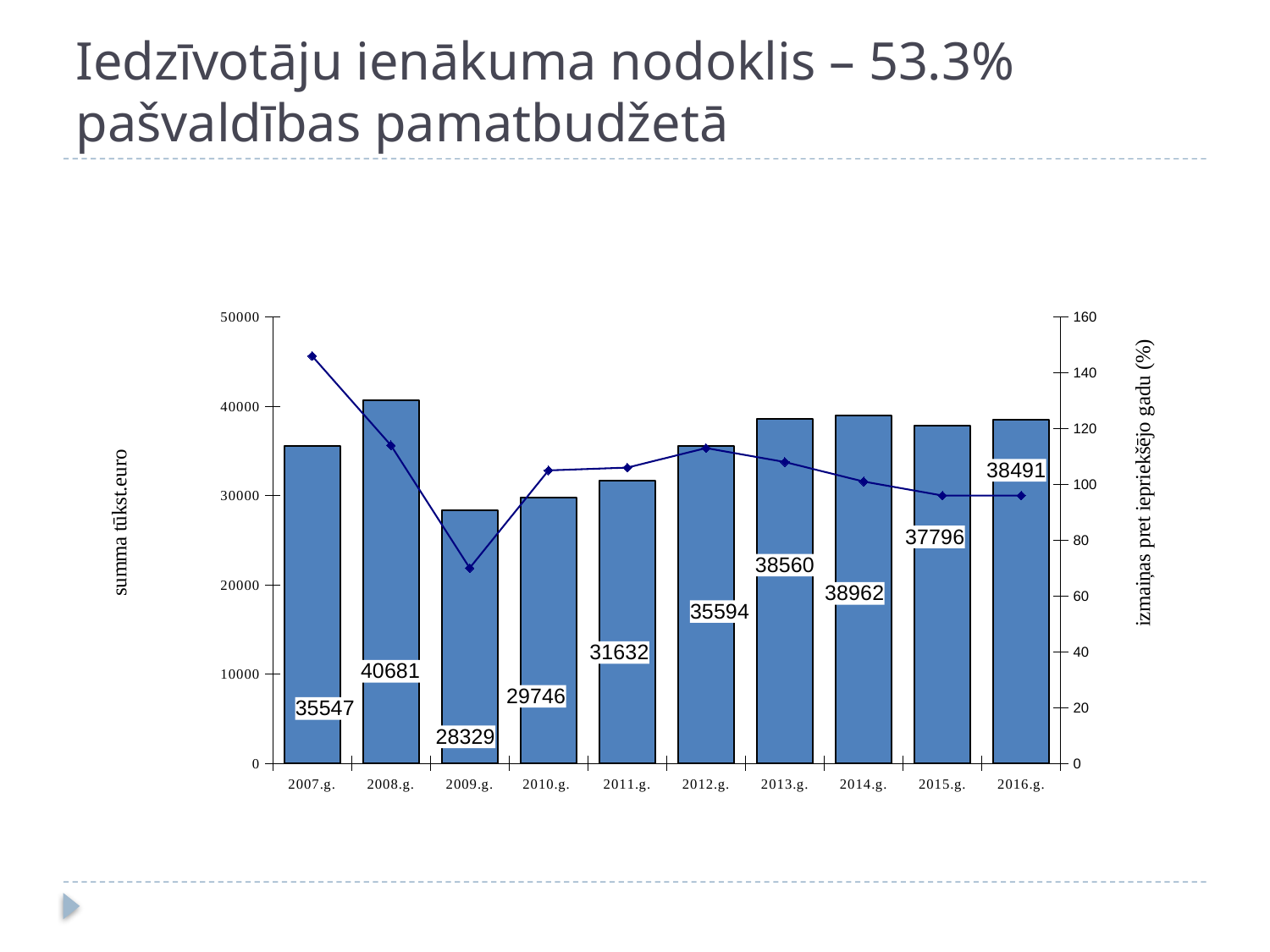
What is the value of the bar for 2012.g.? 35594 What is the value of the bar for 2016.g.? 38491 Is the line value (right axis) for 2009.g. greater or less than 80? less What is the difference between the bar values for 2008.g. and 2009.g.? 12352 Which bar is larger, 2013.g. or 2011.g.? 2013.g. What is the value of the bar for 2008.g.? 40681 Do the bar values rise or fall from 2009.g. to 2014.g.? rise Is the line value (right axis) for 2007.g. greater or less than 140? greater How many years are shown on the x axis? 10 Which year has the highest bar value? 2008.g. Which year has the lowest bar value? 2009.g. What is the difference between the bar values for 2016.g. and 2015.g.? 695